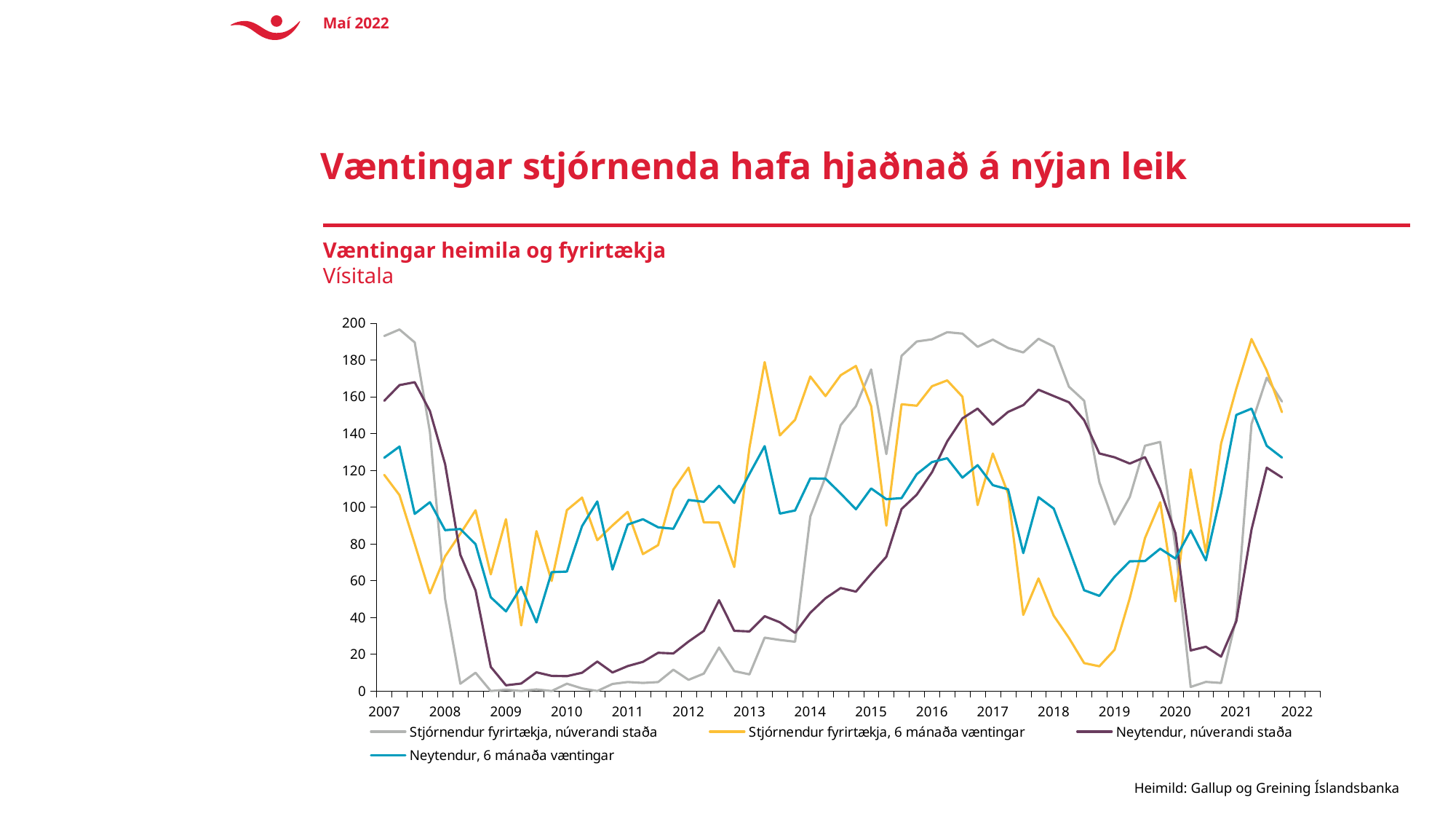
What is the title of the chart? Væntingar heimila og fyrirtækja Which colour is used for the series 'Neytendur, 6 mánaða væntingar'? Blue Does the 'Neytendur, núverandi staða' line rise or fall between 2009 and 2018? Rise Is the value for 'Neytendur, núverandi staða' at the start of 2018 greater or less than 140? greater Is the value for 'Stjórnendur fyrirtækja, núverandi staða' at the start of 2007 greater or less than 180? greater How many series does the legend list? 4 Does the 'Stjórnendur fyrirtækja, núverandi staða' line rise or fall between 2007 and 2009? Fall How many year labels are shown on the x axis? 16 Is the peak of 'Stjórnendur fyrirtækja, 6 mánaða væntingar' in 2013 greater or less than 160? greater What kind of chart is shown on the slide? Line chart